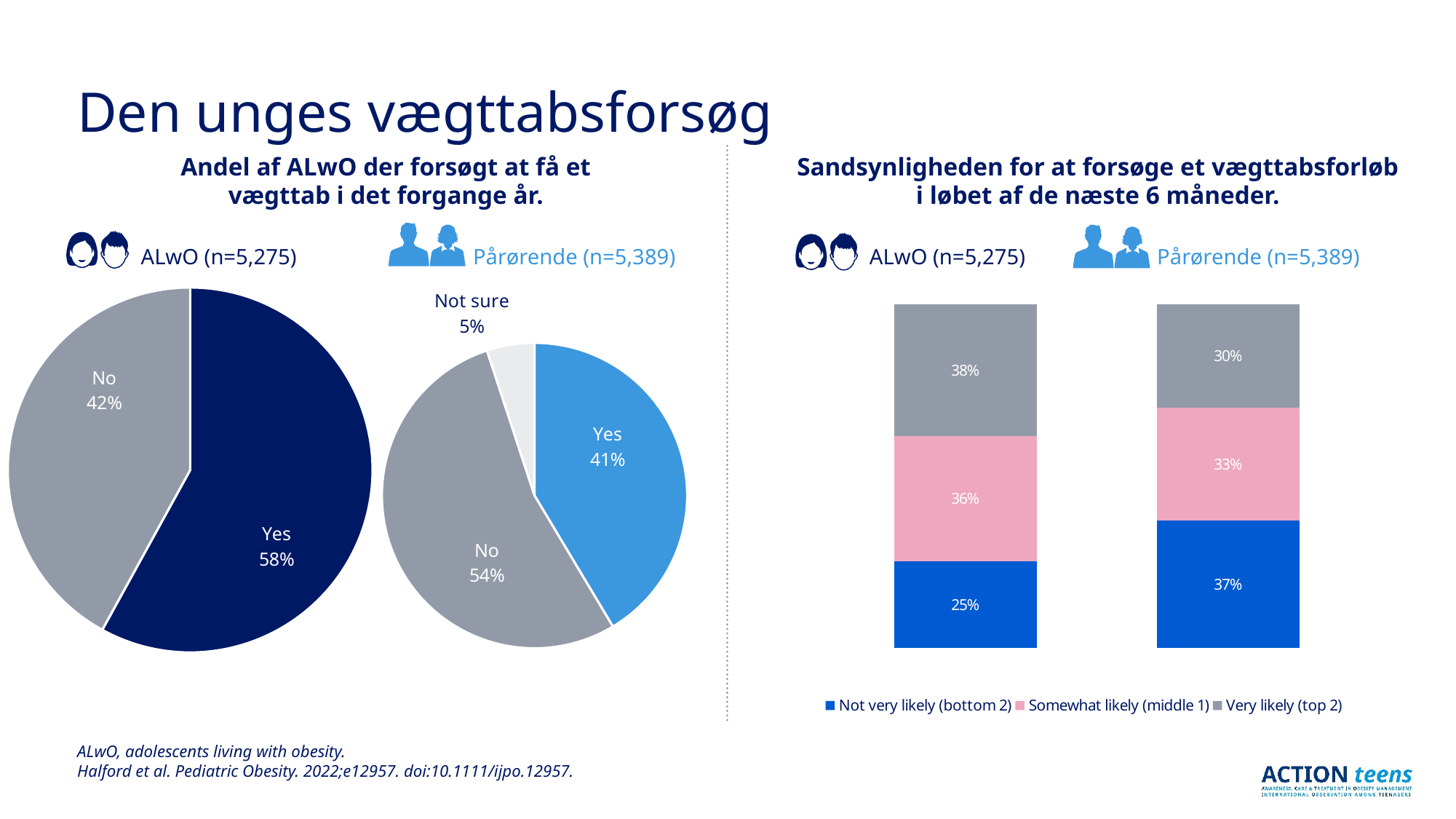
In the ALwO pie chart on the left, what share answered No? 42% In the stacked bar chart on the right, what is the difference between the Not very likely (bottom 2) values for Pårørende and ALwO? 12% In the stacked bar chart on the right, what is the Very likely (top 2) value for ALwO? 38% In the Pårørende pie chart on the left, what is the difference between the No and Yes shares? 13% In the stacked bar chart on the right, what is the Not very likely (bottom 2) value for Pårørende? 37% Which is larger: the Yes share in the ALwO pie chart or the Yes share in the Pårørende pie chart? ALwO pie chart In the Pårørende pie chart on the left, which answer has the largest slice? No What kind of chart is used on the right side of the slide for the likelihood of attempting weight loss in the next 6 months? Stacked bar chart In the ALwO pie chart on the left, what share of ALwO answered Yes? 58% In the Pårørende pie chart on the left, what share answered Not sure? 5% How many series does the legend of the stacked bar chart on the right list? 3 How many slices does the Pårørende pie chart on the left have? 3